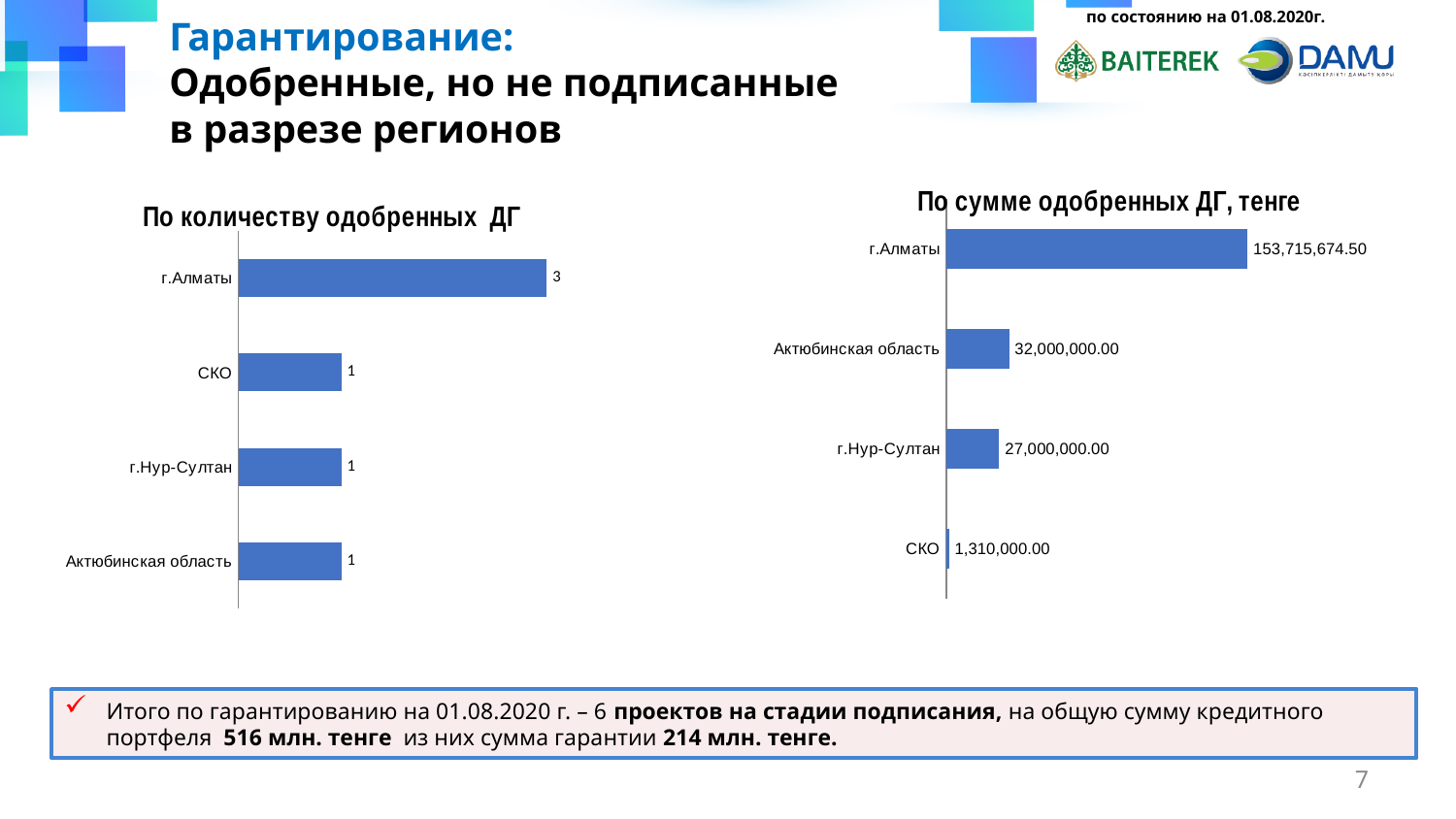
In the chart 'По сумме одобренных ДГ, тенге', which is larger: Актюбинская область or г.Нур-Султан? Актюбинская область In the chart 'По количеству одобренных ДГ', how many regions are shown? 4 In the chart 'По количеству одобренных ДГ', which region has the highest value? г.Алматы In the chart 'По сумме одобренных ДГ, тенге', what is the value for Актюбинская область? 32,000,000.00 In the chart 'По сумме одобренных ДГ, тенге', which region has the lowest value? СКО In the chart 'По количеству одобренных ДГ', what is the value for г.Алматы? 3 What type of chart is 'По сумме одобренных ДГ, тенге'? Bar chart In the chart 'По сумме одобренных ДГ, тенге', what is the value for СКО? 1,310,000.00 In the chart 'По сумме одобренных ДГ, тенге', what is the difference between Актюбинская область and г.Нур-Султан? 5,000,000.00 In the chart 'По сумме одобренных ДГ, тенге', what is the value for г.Алматы? 153,715,674.50 In the chart 'По количеству одобренных ДГ', what is the value for СКО? 1 In the chart 'По количеству одобренных ДГ', what is the difference between г.Алматы and г.Нур-Султан? 2